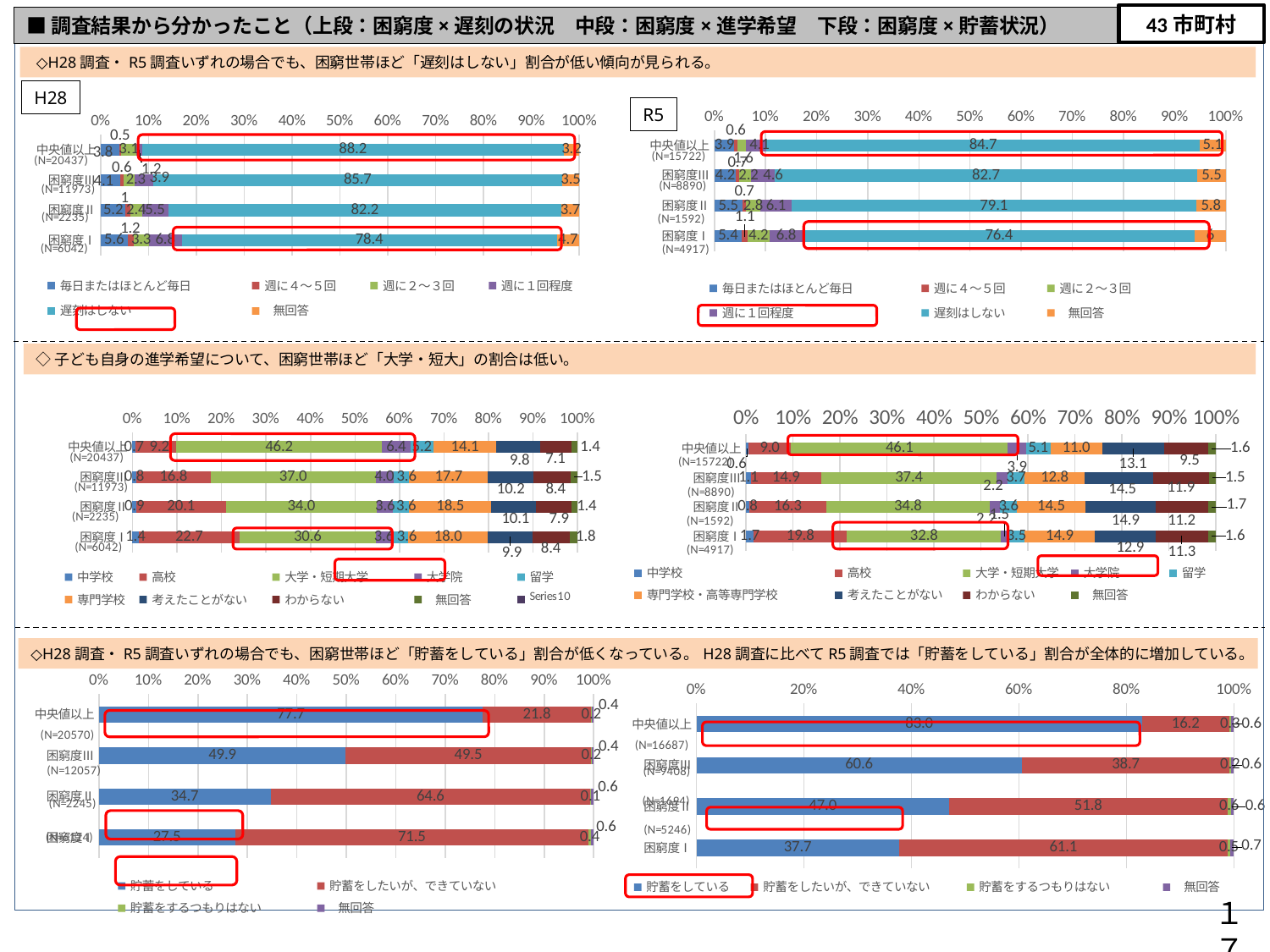
In the bottom-right R5 chart (困窮度 × 貯蓄状況), what is the value of 貯蓄をしたいが、できていない for 困窮度Ⅰ? 61.1 In the middle-right R5 chart (困窮度 × 進学希望), what is the value of 高校 for 困窮度Ⅰ? 19.8 In the top-right R5 chart (困窮度 × 遅刻の状況), what is the value of 遅刻はしない for 困窮度Ⅰ? 76.4 What kind of chart is the bottom-left H28 chart (困窮度 × 貯蓄状況)? stacked bar chart In the bottom-right R5 chart (困窮度 × 貯蓄状況), how many series does the legend list? 4 In the middle-right R5 chart (困窮度 × 進学希望), which is larger for 困窮度Ⅱ: 大学・短大 or 高校? 大学・短大 In the top-left H28 chart (困窮度 × 遅刻の状況), which category has the lowest value for 遅刻はしない? 困窮度Ⅰ In the middle-left H28 chart (困窮度 × 進学希望), what is the value of 大学・短大 for 困窮度Ⅰ? 30.6 In the bottom-left H28 chart (困窮度 × 貯蓄状況), what is the value of 貯蓄をしている for 中央値以上? 77.7 In the top-right R5 chart (困窮度 × 遅刻の状況), what is the difference between the 遅刻はしない values for 中央値以上 and 困窮度Ⅰ? 8.3 In the middle-left H28 chart (困窮度 × 進学希望), does the value of 大学・短大 rise or fall going from 中央値以上 down to 困窮度Ⅰ? fall In the top-left H28 chart (困窮度 × 遅刻の状況), what is the value of 遅刻はしない for 中央値以上? 88.2